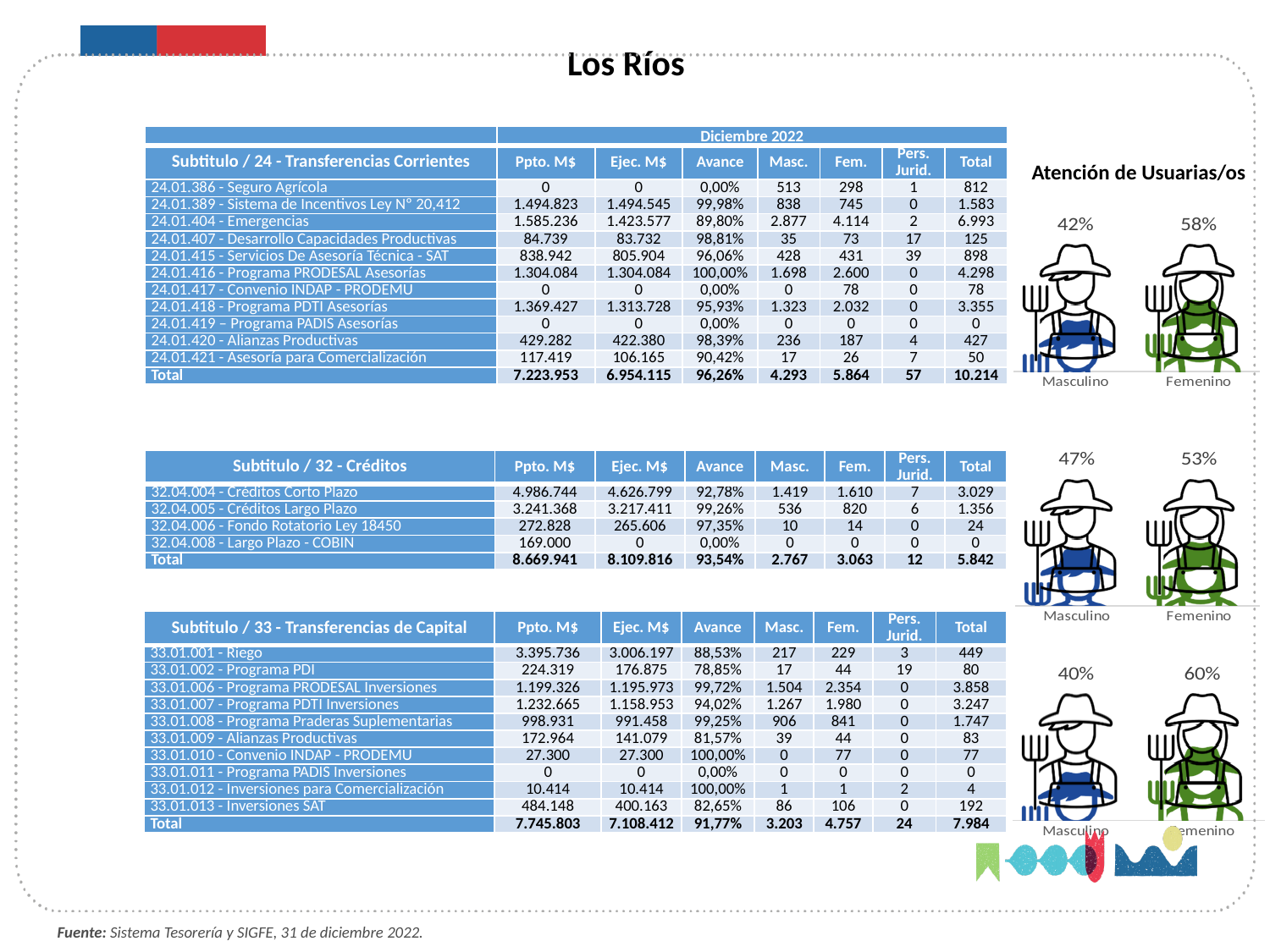
In the middle pictograph (next to the Subtítulo 32 - Créditos table), what percentage is shown for Masculino? 47% How many categories does each pictograph on the right side of the slide show? 2 In the bottom pictograph (next to the Subtítulo 33 - Transferencias de Capital table), what percentage is shown for Femenino? 60% In the top 'Atención de Usuarias/os' pictograph (next to the Subtítulo 24 table), what percentage is shown for Masculino? 42% In the middle pictograph, what is the difference in percentage points between Femenino and Masculino? 6 percentage points In the bottom pictograph, what is the difference in percentage points between Femenino and Masculino? 20 percentage points In the middle pictograph (next to the Subtítulo 32 - Créditos table), what percentage is shown for Femenino? 53% In the top 'Atención de Usuarias/os' pictograph (next to the Subtítulo 24 table), what percentage is shown for Femenino? 58% What is the title printed above the top pictograph on the right side of the slide? Atención de Usuarias/os In the bottom pictograph (next to the Subtítulo 33 table), what percentage is shown for Masculino? 40% In the top pictograph, which group has the higher share, Masculino or Femenino? Femenino What kind of chart is used on the right side of the slide to show the Masculino and Femenino shares? Pictograph (icon chart)